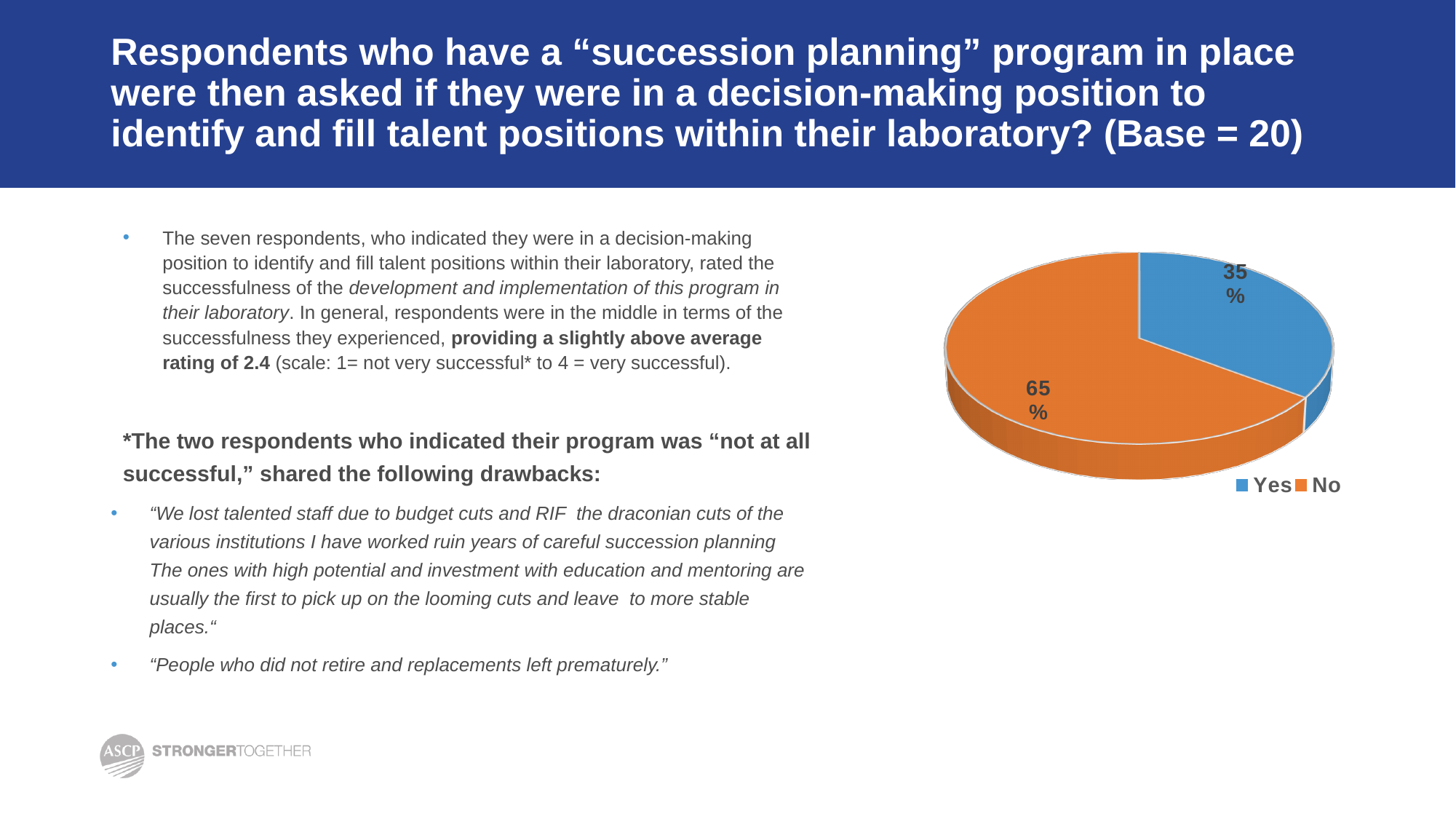
What colour is the No slice in the pie chart? orange What type of chart is shown on the slide? pie chart Which response has the smallest share of the pie chart? Yes Is the share for Yes greater or less than 50%? less What is the difference in percentage points between the No and Yes slices? 30 What percentage of respondents answered Yes in the pie chart? 35% How many slices does the pie chart have? 2 Which slice is larger, Yes or No? No How many entries does the chart legend list? 2 What percentage of respondents answered No in the pie chart? 65% Which response has the largest share of the pie chart? No What colour is the Yes slice in the pie chart? blue